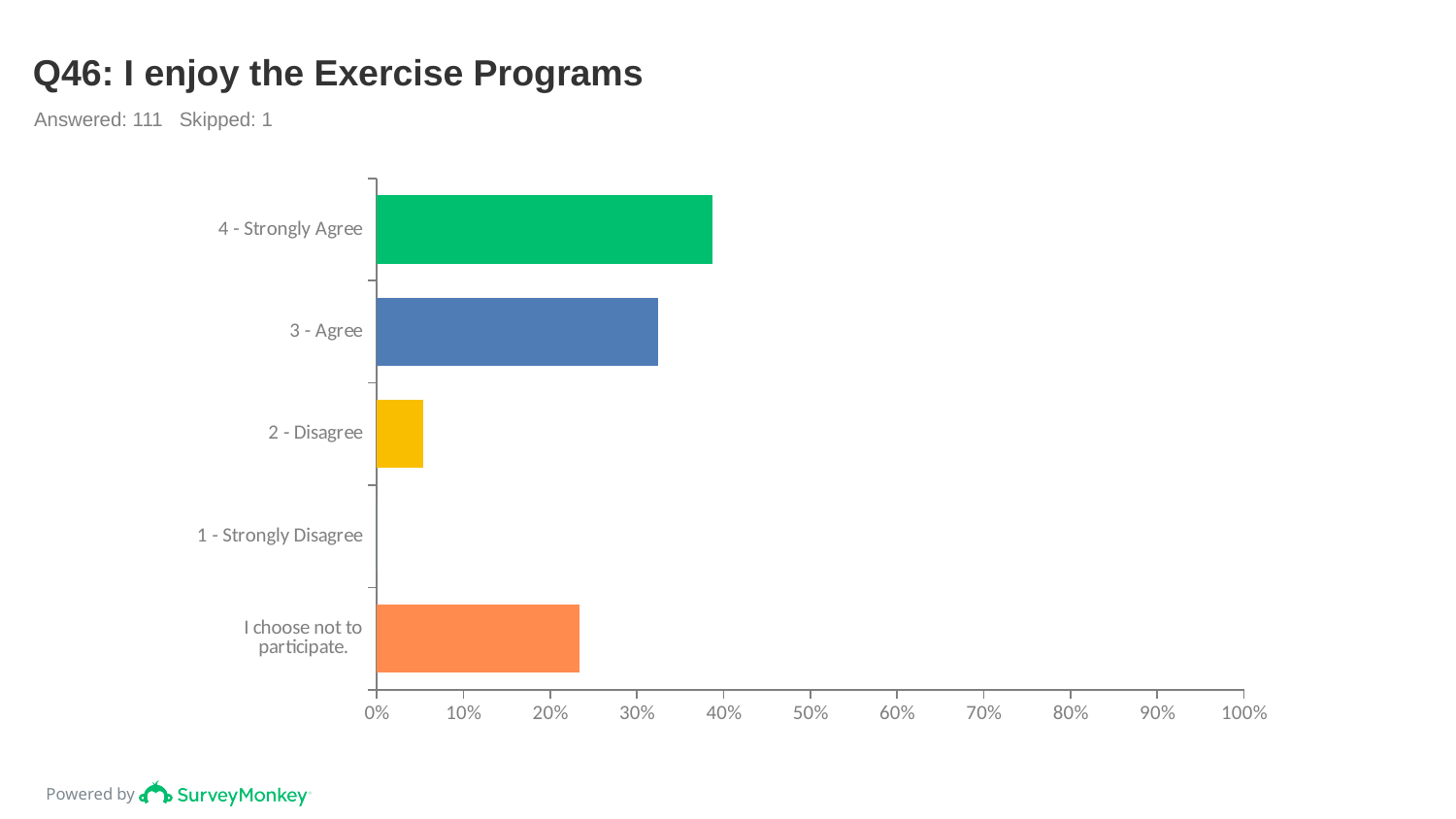
Which is larger, the value for 3 - Agree or the value for I choose not to participate.? 3 - Agree Is the value for 2 - Disagree greater or less than 10%? less How many respondents answered the question according to the slide? 111 Which category has the lowest value? 1 - Strongly Disagree Is the value for I choose not to participate. greater or less than 20%? greater Is the value for 3 - Agree greater or less than 40%? less How many categories are shown on the chart? 5 What is the title of the chart? Q46: I enjoy the Exercise Programs Which category has the highest value? 4 - Strongly Agree Which is larger, the value for 2 - Disagree or the value for I choose not to participate.? I choose not to participate. What kind of chart is shown on the slide? bar chart